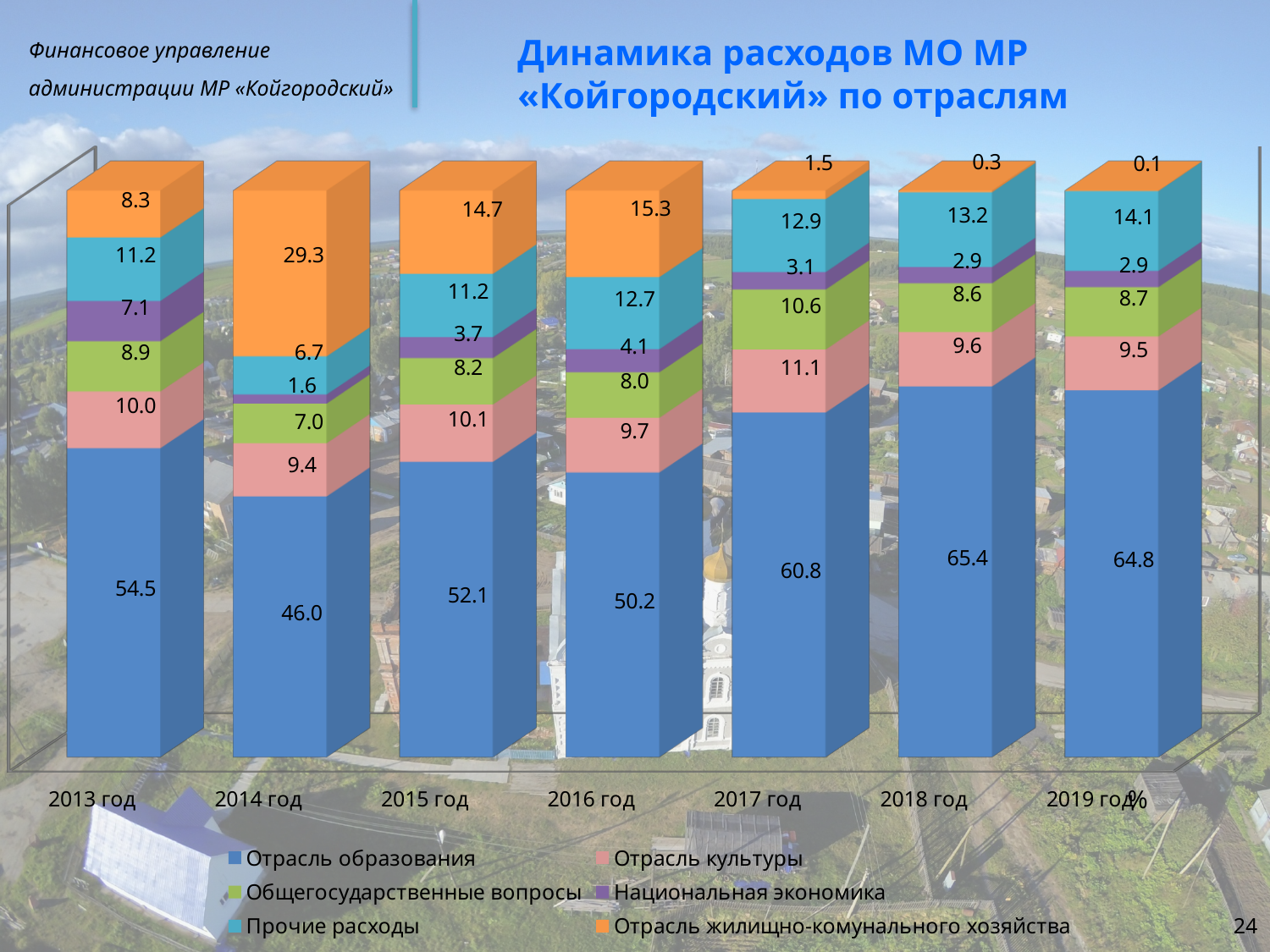
How many years (categories) are shown on the x axis? 7 What is the difference between the Отрасль образования values for 2018 год and 2013 год? 10.9 Does the value for Отрасль жилищно-комунального хозяйства rise or fall from 2016 год to 2019 год? Fall In which year is the value for Отрасль образования the lowest? 2014 год What is the value for Национальная экономика in 2016 год? 4.1 What is the value for Отрасль образования in 2018 год? 65.4 How many series does the legend list? 6 Which is larger: Прочие расходы in 2019 год or Прочие расходы in 2013 год? 2019 год What is the value for Отрасль жилищно-комунального хозяйства in 2014 год? 29.3 What kind of chart is shown on the slide? Stacked bar chart In which year is the value for Отрасль жилищно-комунального хозяйства the highest? 2014 год Which series is shown in orange in the legend? Отрасль жилищно-комунального хозяйства